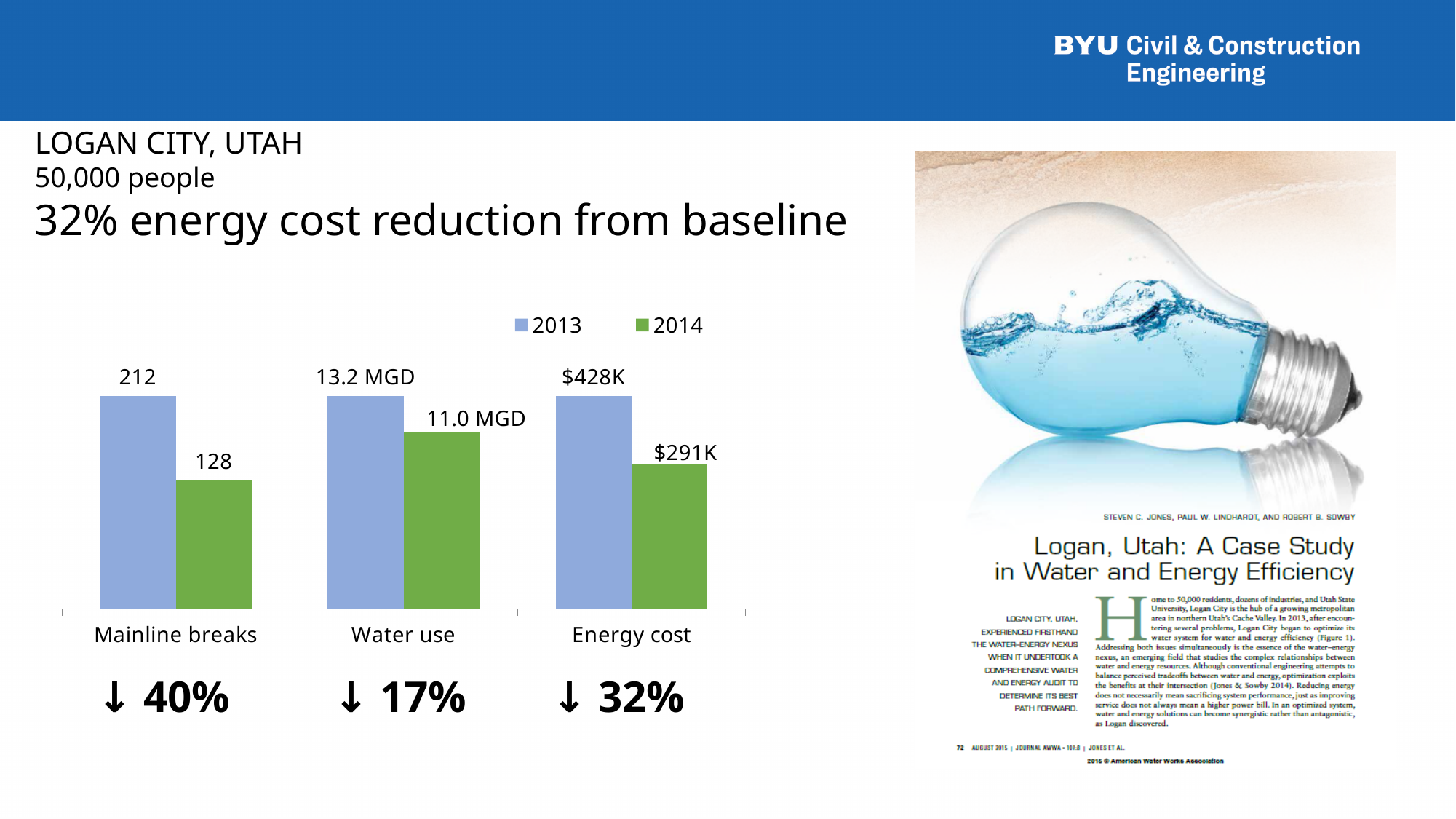
What was the water use in 2013? 13.2 MGD By how much did the number of mainline breaks decrease from 2013 to 2014? 84 Which colour represents the 2014 series in the chart? Green How many categories are shown on the x axis of the chart? 3 What was the water use in 2014? 11.0 MGD How many series does the chart legend list? 2 What kind of chart is shown on the slide? Bar chart Which year had the higher energy cost, 2013 or 2014? 2013 What was the energy cost in 2014? $291K What was the number of mainline breaks in 2013? 212 What was the energy cost in 2013? $428K What was the number of mainline breaks in 2014? 128